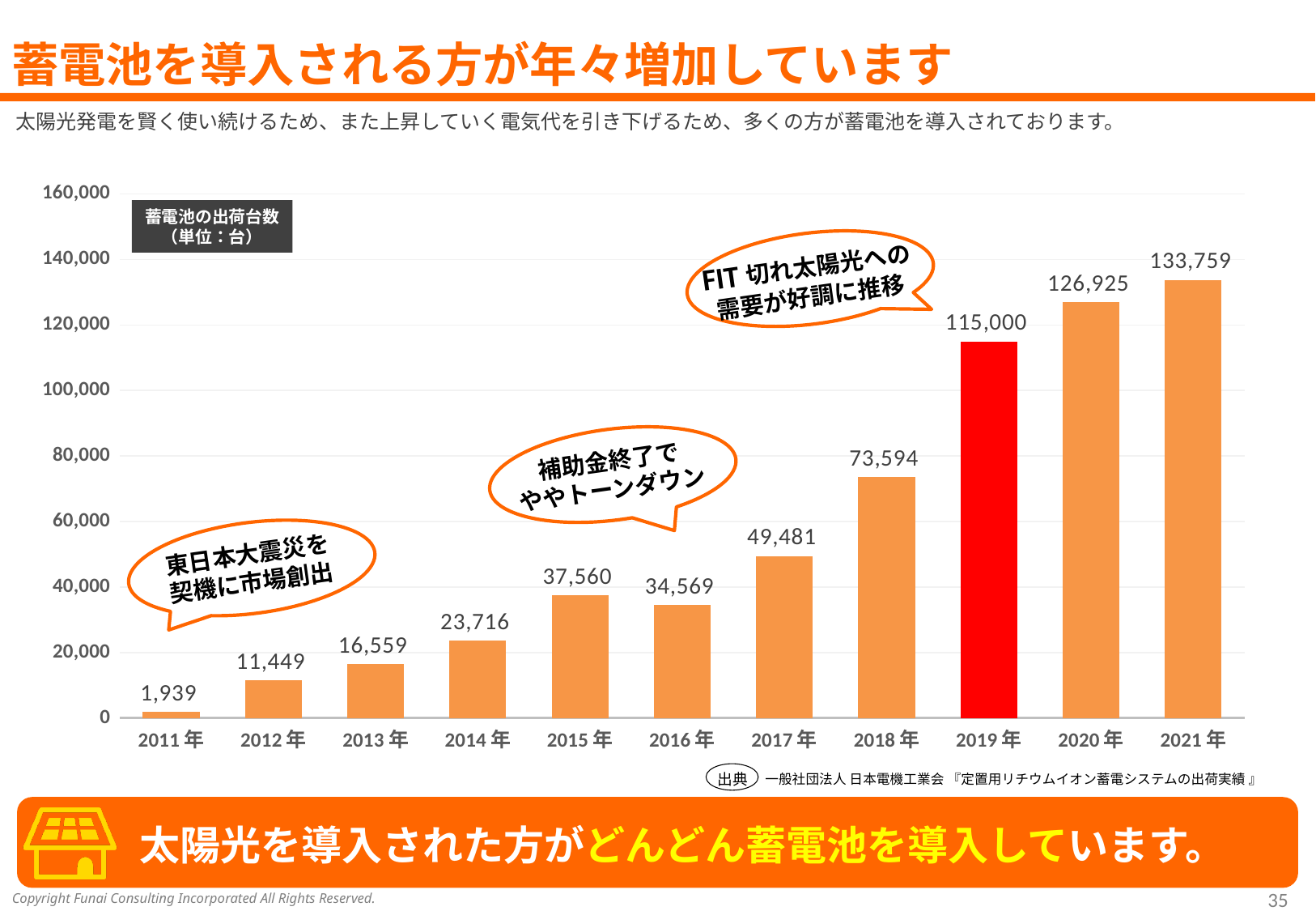
What is the difference between the values for 2021年 and 2020年? 6,834 Which is larger, the value for 2015年 or the value for 2016年? 2015年 What is the value shown for 2011年? 1,939 Which year has the lowest value? 2011年 Is the value for 2018年 greater or less than 80,000? less Which bar is coloured red instead of orange? 2019年 How many years are shown on the x axis? 11 What kind of chart is shown on the slide? bar chart What is the value shown for 2014年? 23,716 What is the difference between the values for 2015年 and 2016年? 2,991 What is the value shown for 2019年? 115,000 Which year has the highest value? 2021年